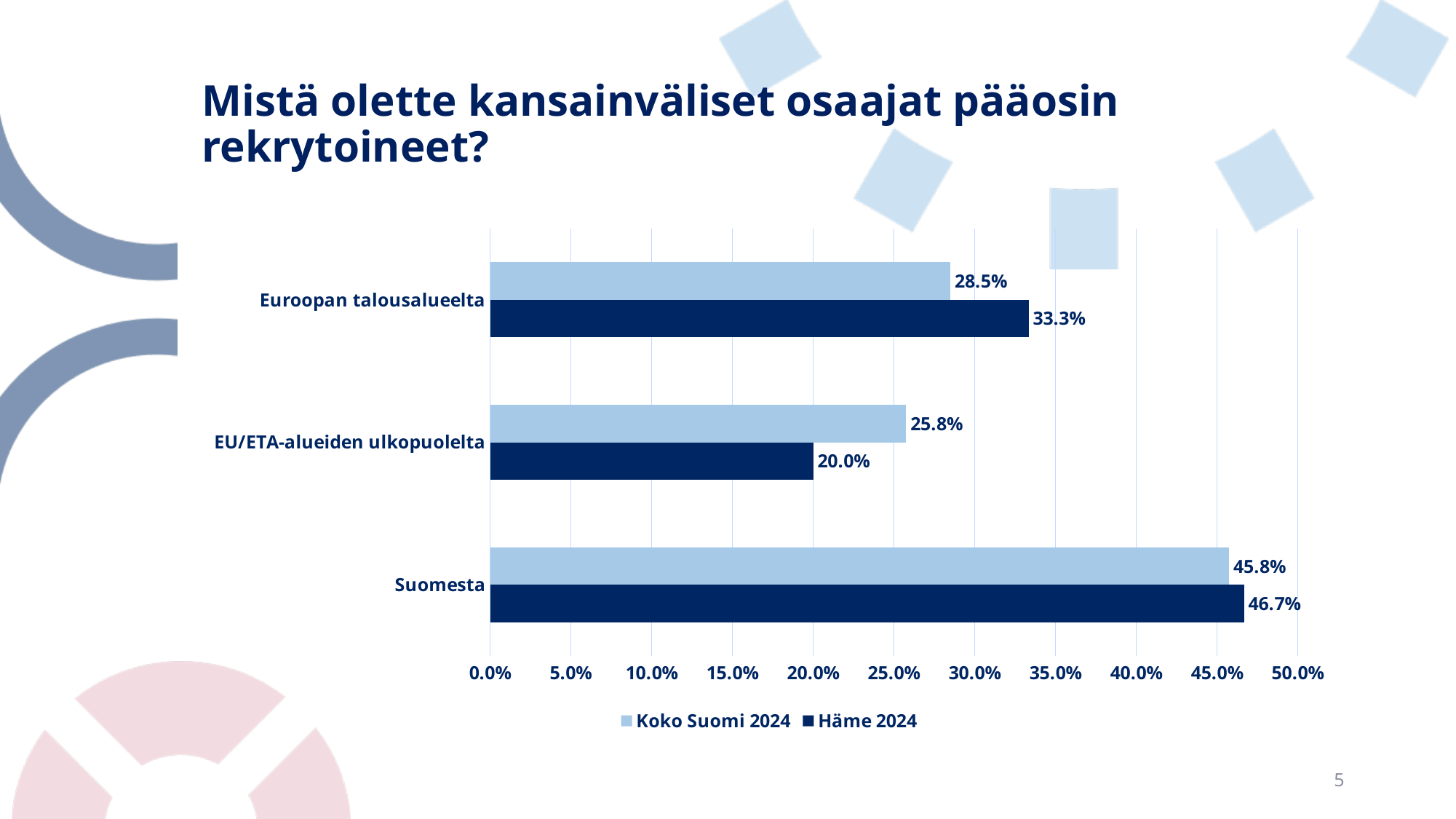
Which category has the highest value for Koko Suomi 2024? Suomesta What is the value for Häme 2024 for EU/ETA-alueiden ulkopuolelta? 20.0% Which category has the lowest value for Häme 2024? EU/ETA-alueiden ulkopuolelta How many series does the legend list? 2 Is the Koko Suomi 2024 value for Suomesta greater or less than 40.0%? greater What is the value for Koko Suomi 2024 for Euroopan talousalueelta? 28.5% What is the value for Häme 2024 for Suomesta? 46.7% For EU/ETA-alueiden ulkopuolelta, which series has the larger value, Koko Suomi 2024 or Häme 2024? Koko Suomi 2024 How many categories are shown on the chart? 3 What kind of chart is shown on the slide? Bar chart What is the difference between the Häme 2024 and Koko Suomi 2024 values for Euroopan talousalueelta? 4.8% Which series is shown in dark blue in the legend? Häme 2024